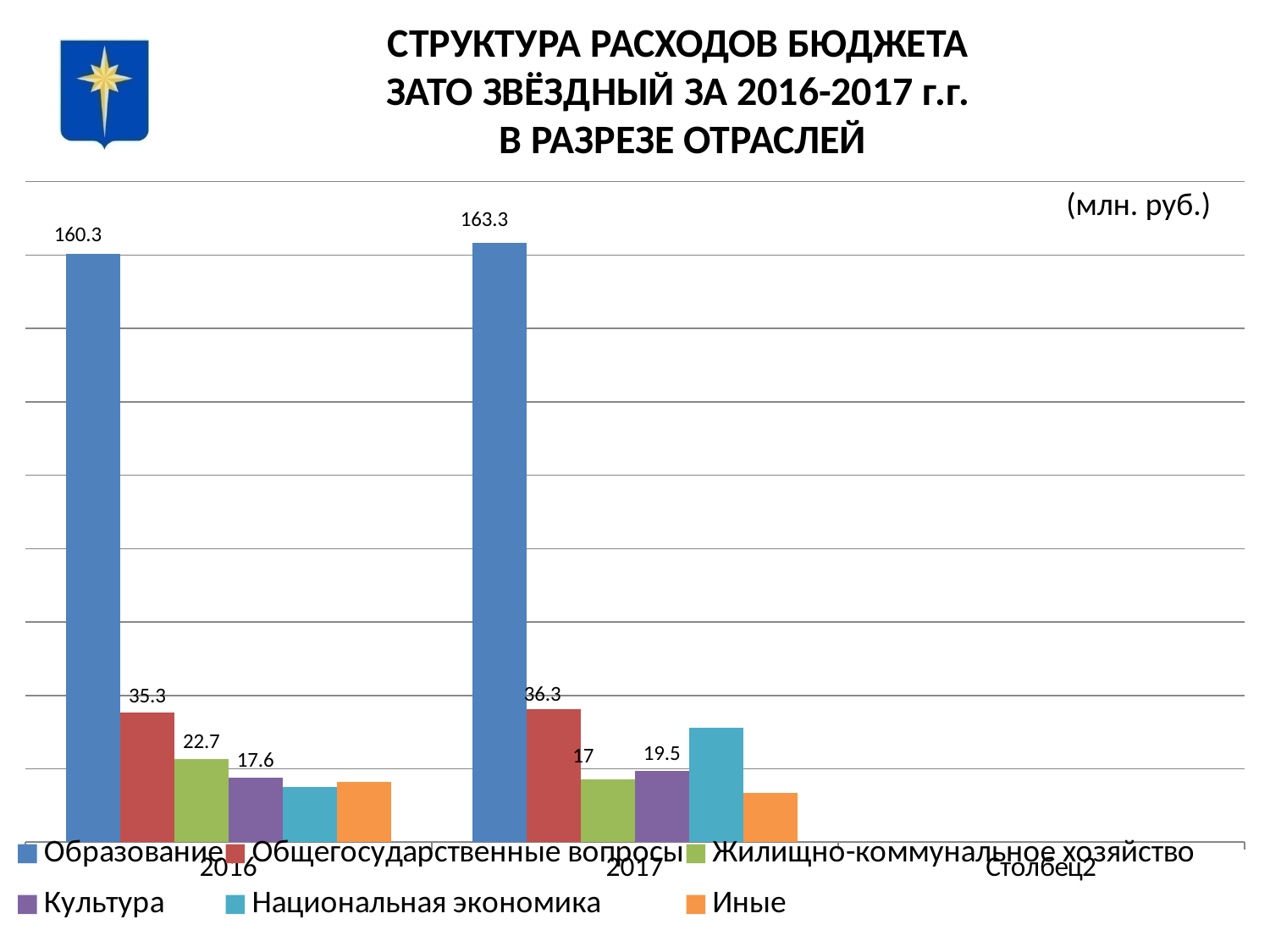
Is the value for Жилищно-коммунальное хозяйство larger in 2016 or in 2017? 2016 Is the value for Культура larger in 2016 or in 2017? 2017 What is the value for Образование in 2017? 163.3 What kind of chart is shown on the slide? Bar chart What is the value for Образование in 2016? 160.3 What is the value for Культура in 2016? 17.6 Which series has the highest value in 2016? Образование What is the value for Жилищно-коммунальное хозяйство in 2017? 17 What is the difference between the Общегосударственные вопросы values for 2017 and 2016? 1 By how much did the value for Образование increase from 2016 to 2017? 3 What is the value for Общегосударственные вопросы in 2016? 35.3 How many series does the legend list? 6